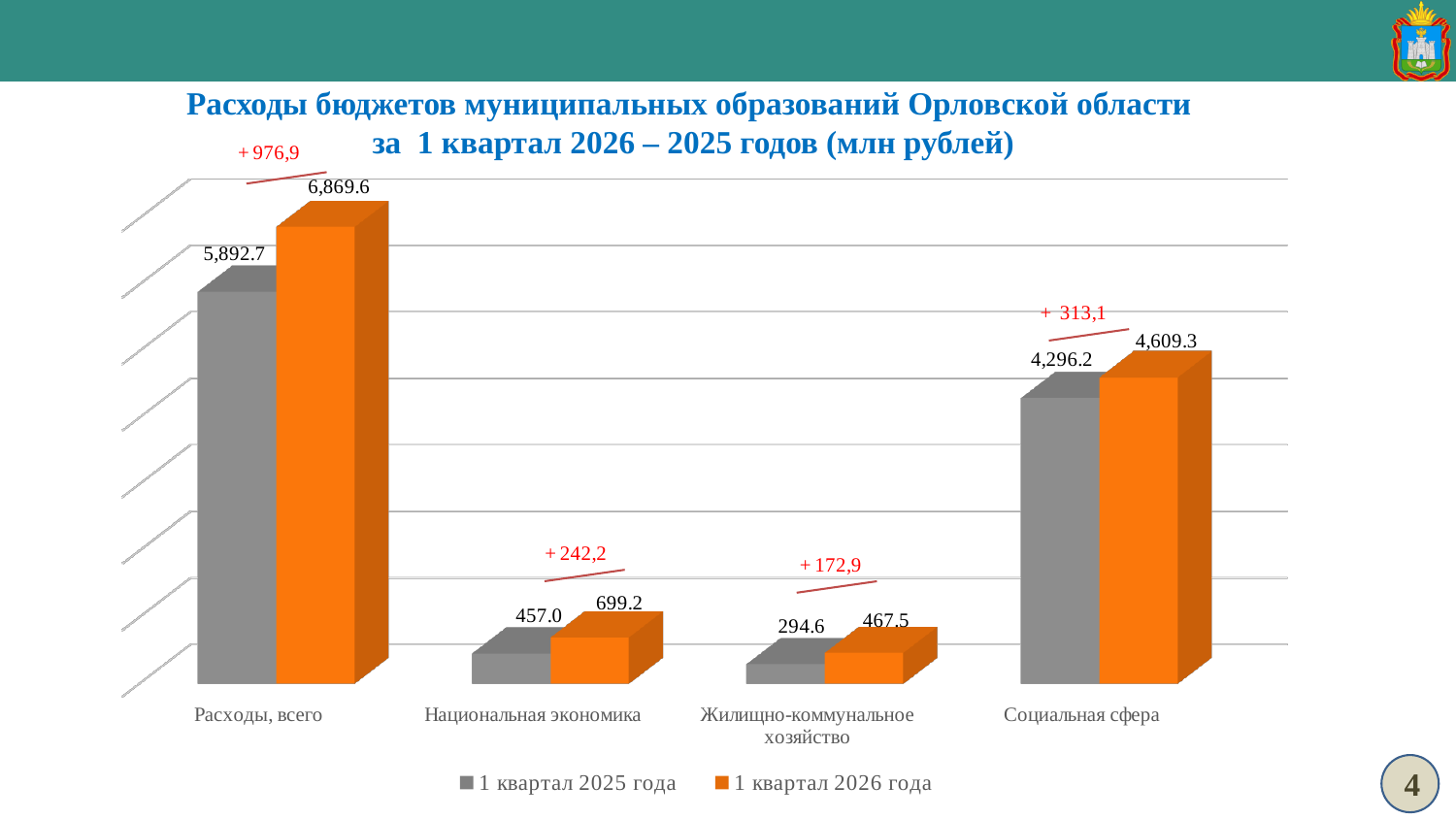
What is the value for Жилищно-коммунальное хозяйство in the 1 квартал 2026 года series? 467.5 What is the value for Национальная экономика in the 1 квартал 2025 года series? 457.0 How many categories are shown on the x axis of the chart? 4 What is the value for Расходы, всего in the 1 квартал 2026 года series? 6,869.6 What is the difference between the 1 квартал 2026 года and 1 квартал 2025 года values for Социальная сфера? 313.1 Which category has the lowest value in the 1 квартал 2025 года series? Жилищно-коммунальное хозяйство Which is larger for Жилищно-коммунальное хозяйство: the 1 квартал 2025 года value or the 1 квартал 2026 года value? 1 квартал 2026 года How many series does the legend list? 2 Which category has the highest value in the 1 квартал 2026 года series? Расходы, всего What is the difference between the 1 квартал 2026 года and 1 квартал 2025 года values for Национальная экономика? 242.2 What kind of chart is shown on the slide? Bar chart What is the value for Социальная сфера in the 1 квартал 2025 года series? 4,296.2